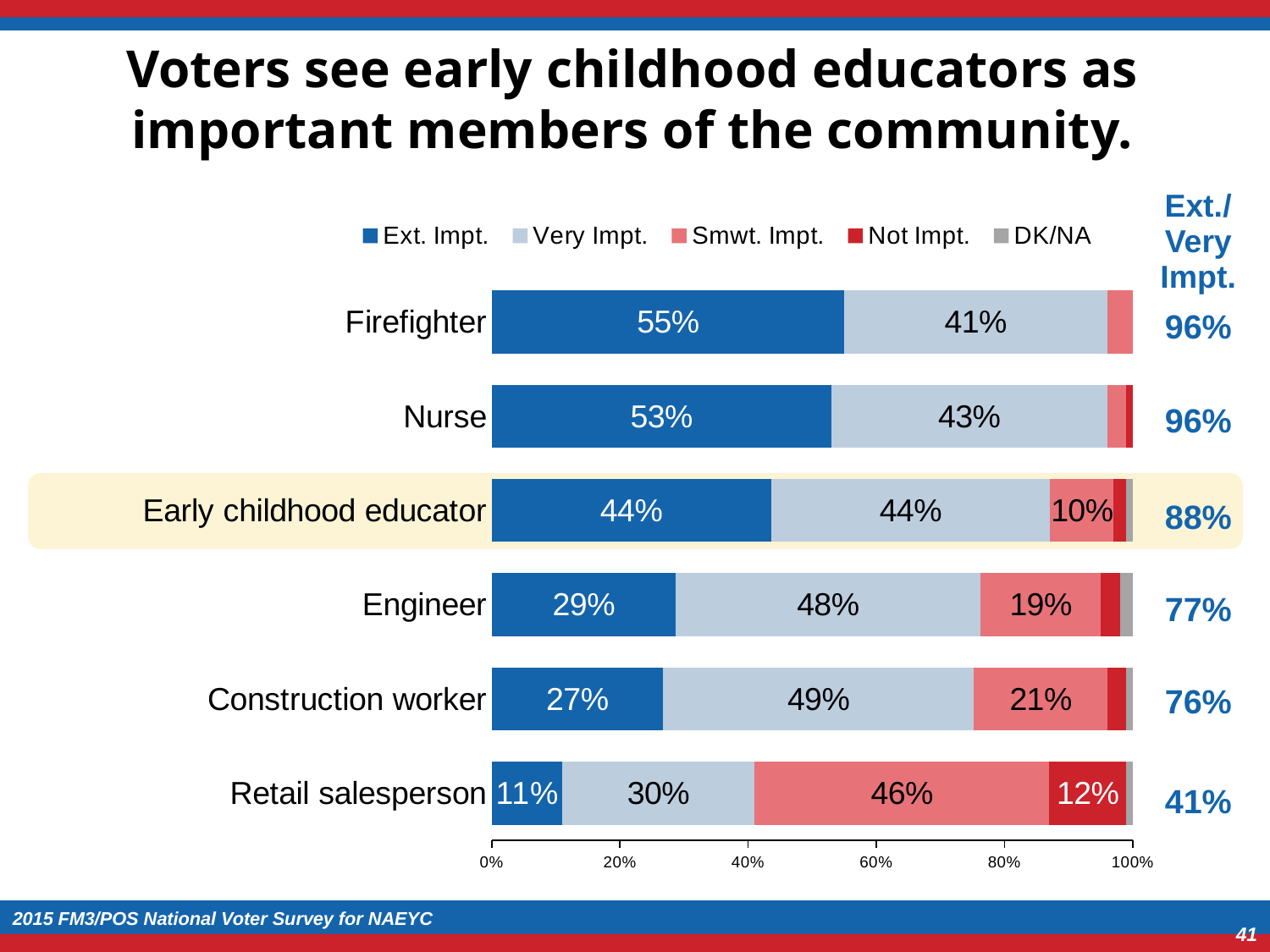
Which is larger, the Smwt. Impt. value for Engineer or for Construction worker? Construction worker Which occupation has the lowest Ext./Very Impt. combined figure? Retail salesperson What is the difference between the Ext. Impt. values for Nurse and Engineer? 24% How many series does the legend list? 5 What is the Ext./Very Impt. combined figure shown for Early childhood educator? 88% Which occupation has the highest Ext. Impt. value? Firefighter What is the Smwt. Impt. value for Retail salesperson? 46% Which occupation's row is highlighted with a shaded background? Early childhood educator How many occupations are shown in the chart? 6 What is the Ext. Impt. value for Firefighter? 55% What type of chart is shown on the slide? Stacked bar chart What is the Very Impt. value for Construction worker? 49%